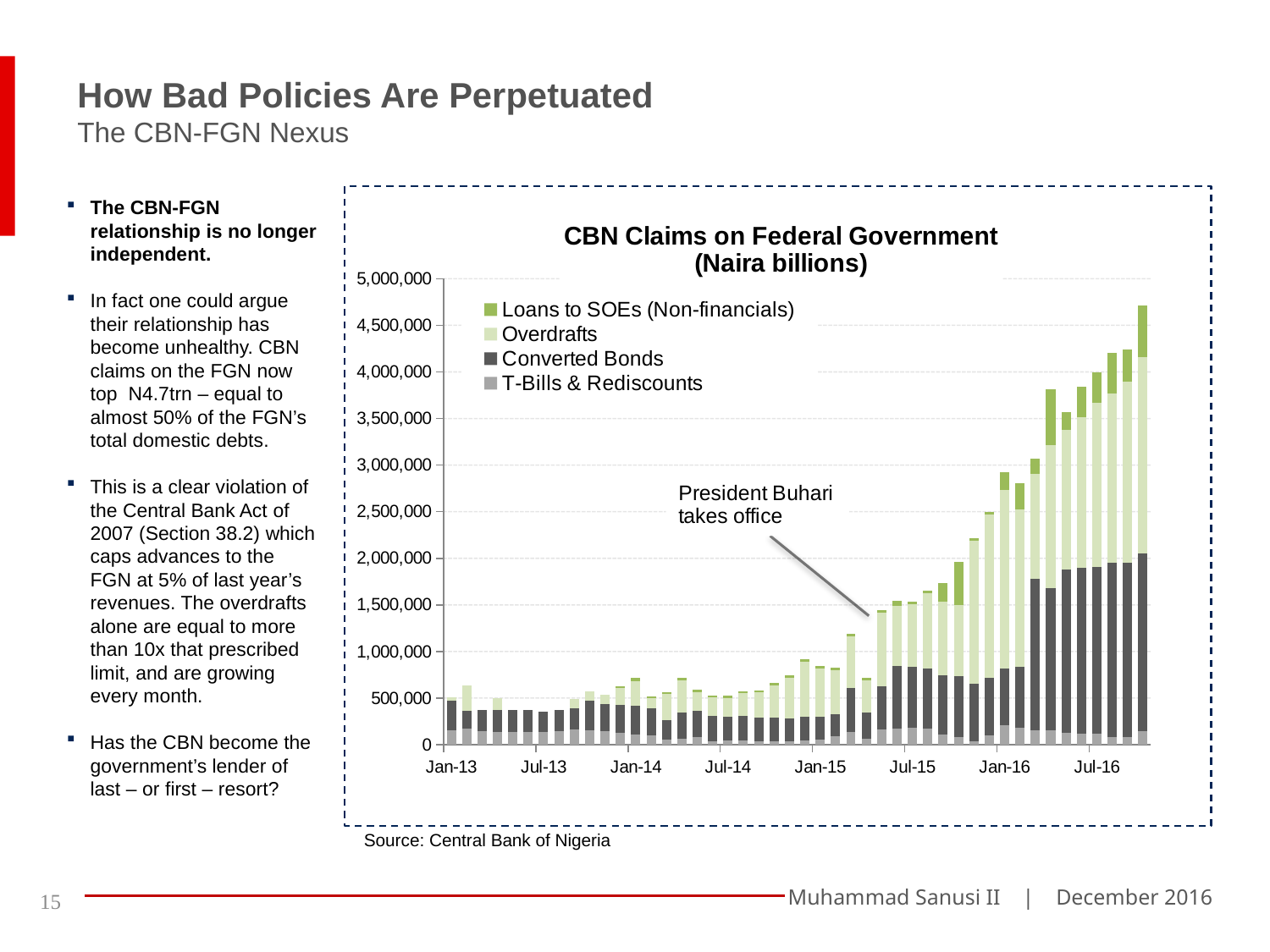
Which has the larger total, the bar at Jan-13 or the bar at Jul-16? Jul-16 Is the total value of the bar at Jan-15 greater or less than 1,000,000? less Which series is shown in the darkest grey in the chart? Converted Bonds Is the total value of the bar at Jul-15 greater or less than 1,000,000? greater Of the months labelled on the x axis, which has the highest total CBN claims? Jul-16 Do the total CBN claims on the Federal Government rise or fall from Jan-13 to Jul-16? Rise Is the total value of the bar at Jan-16 greater or less than 2,500,000? greater What kind of chart is shown on the slide? Stacked bar chart How many series does the legend of the chart list? 4 What is the title of the chart? CBN Claims on Federal Government (Naira billions)